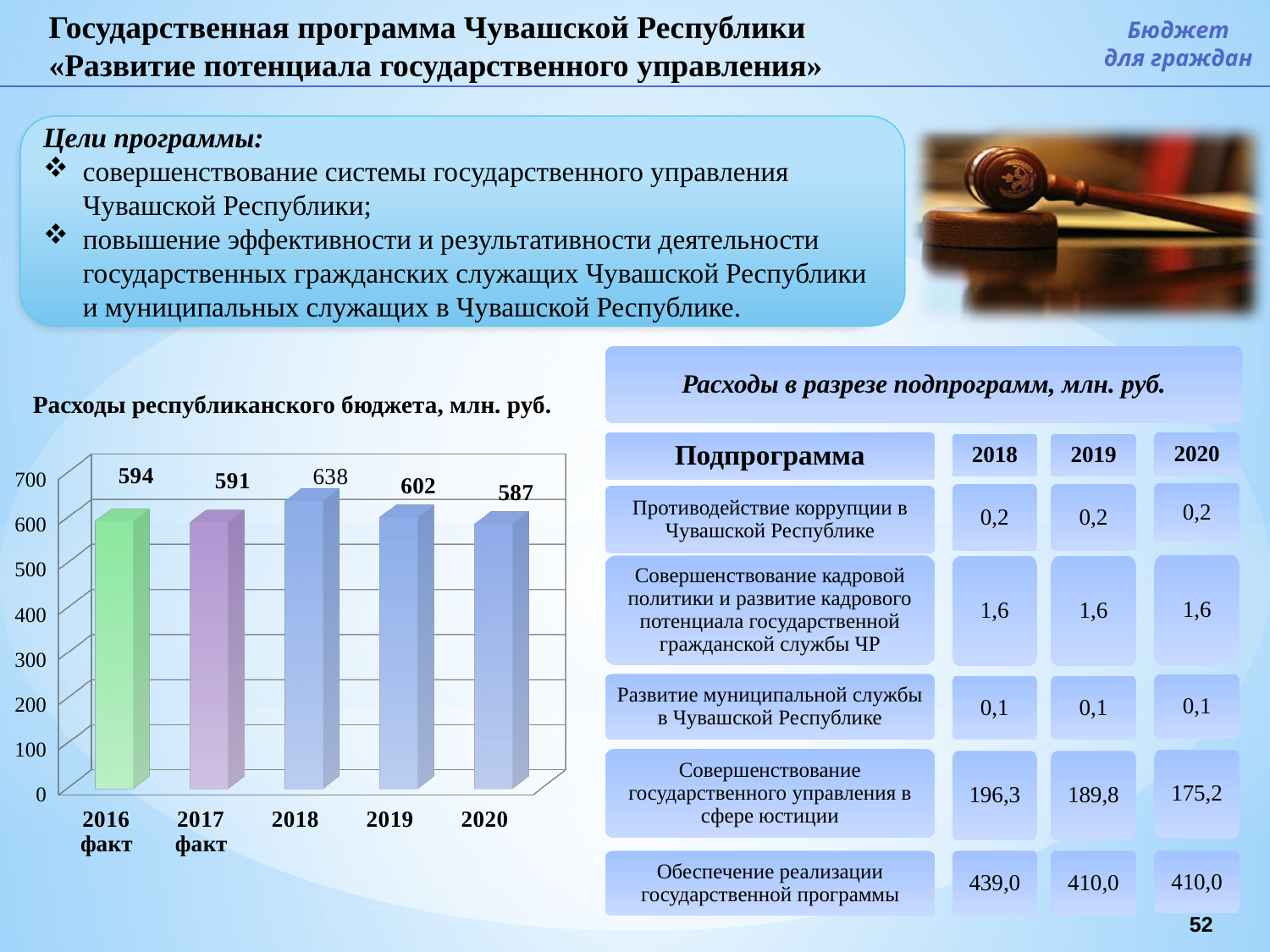
What kind of chart is "Расходы республиканского бюджета, млн. руб."? bar chart Which year has the highest value in the chart "Расходы республиканского бюджета, млн. руб."? 2018 What is the difference between the values for 2018 and 2020 in the chart "Расходы республиканского бюджета, млн. руб."? 51 In the chart "Расходы республиканского бюджета, млн. руб.", do the values rise or fall from 2018 to 2020? fall In the chart "Расходы республиканского бюджета, млн. руб.", is the value for 2019 greater or less than 500? greater What is the difference between the values for 2019 and 2017 факт in the chart "Расходы республиканского бюджета, млн. руб."? 11 What is the value for 2018 in the chart "Расходы республиканского бюджета, млн. руб."? 638 What is the value for 2016 факт in the chart "Расходы республиканского бюджета, млн. руб."? 594 What is the value for 2020 in the chart "Расходы республиканского бюджета, млн. руб."? 587 How many bars are shown in the chart "Расходы республиканского бюджета, млн. руб."? 5 In the chart "Расходы республиканского бюджета, млн. руб.", which is larger: the value for 2016 факт or the value for 2017 факт? 2016 факт Which year has the lowest value in the chart "Расходы республиканского бюджета, млн. руб."? 2020